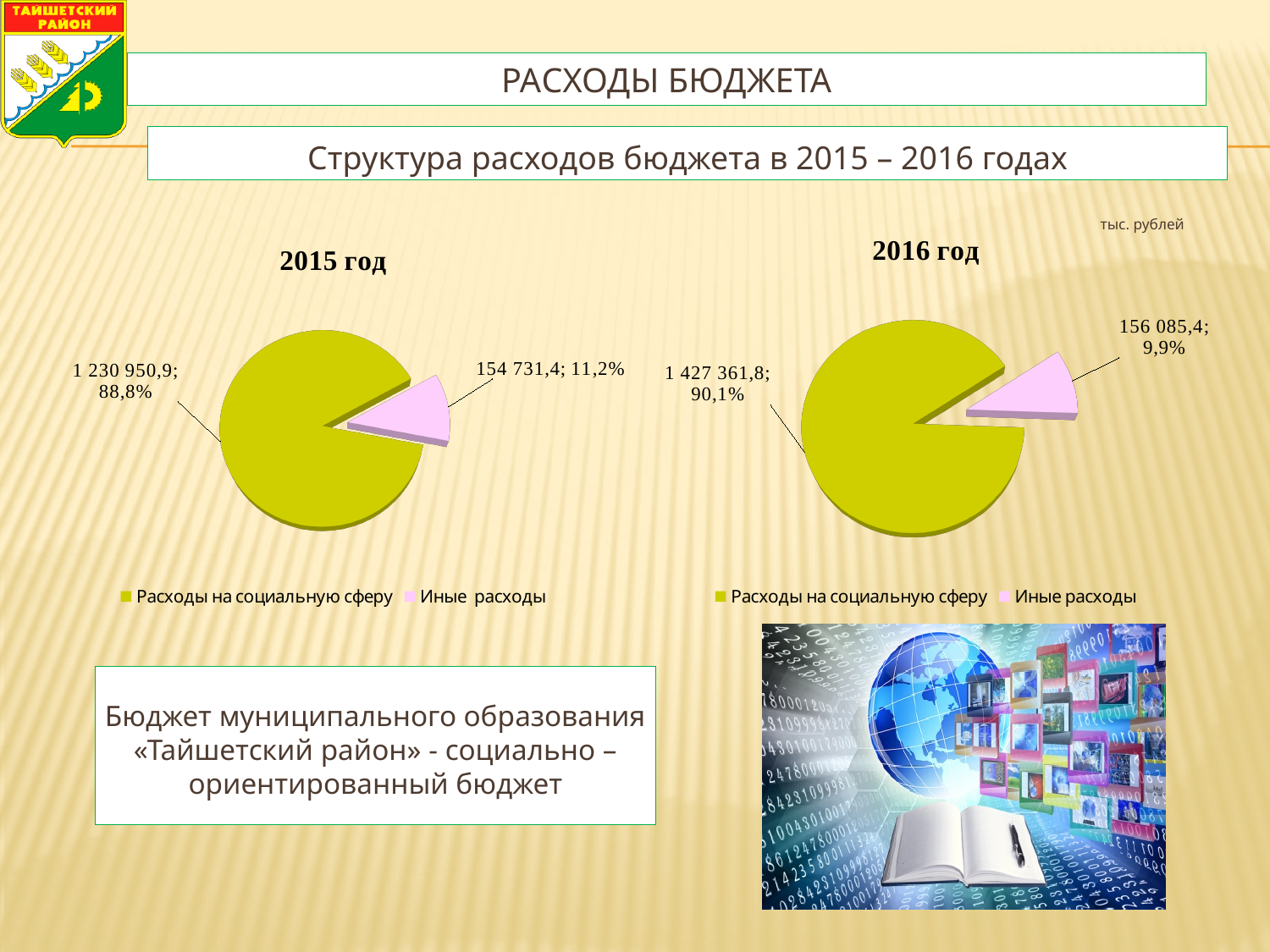
In the "2016 год" chart, what is the value for "Расходы на социальную сферу"? 1 427 361,8 In the "2015 год" chart, which category is the largest? Расходы на социальную сферу Which is larger: "Иные расходы" in the "2015 год" chart or "Иные расходы" in the "2016 год" chart? 2016 год In the "2015 год" chart, what is the value for "Расходы на социальную сферу"? 1 230 950,9 In the "2016 год" chart, what is the value for "Иные расходы"? 156 085,4 What is the difference between the "Расходы на социальную сферу" share in the "2016 год" chart and in the "2015 год" chart? 1,3% How many categories does the "2016 год" chart show? 2 In the "2015 год" chart, what share of the pie is "Иные расходы"? 11,2% In the "2016 год" chart, what share of the pie is "Расходы на социальную сферу"? 90,1% What kind of chart is the "2015 год" chart? Pie chart In the "2016 год" chart, which category is the smallest? Иные расходы What colour represents "Иные расходы" in the "2015 год" chart? Pink